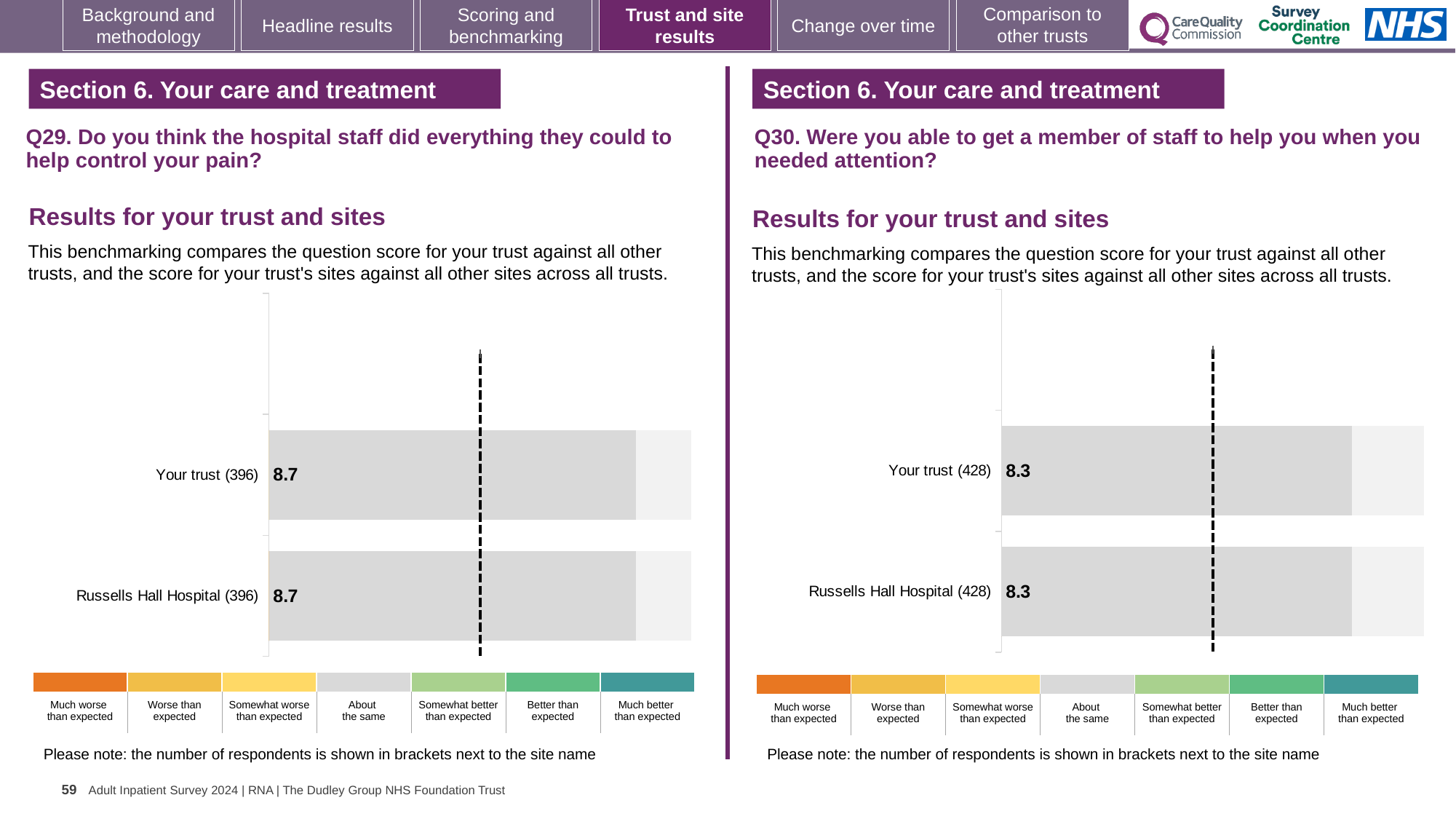
In the Q30 chart on the right, what is the difference between the score for Your trust and the score for Russells Hall Hospital? 0 In the Q29 chart on the left, what is the difference between the score for Your trust and the score for Russells Hall Hospital? 0 In the Q29 chart on the left, what is the score for Your trust? 8.7 In the Q30 chart on the right, what is the score for Your trust? 8.3 How many bars are plotted in the Q30 chart on the right? 2 What kind of chart is the Q29 chart on the left? Bar chart Is the score for Your trust in the Q29 chart on the left larger or smaller than the score for Your trust in the Q30 chart on the right? Larger How many bars are plotted in the Q29 chart on the left? 2 In the Q29 chart on the left, how many respondents are shown in brackets next to Your trust? 396 In the Q29 chart on the left, what is the score for Russells Hall Hospital? 8.7 In the Q30 chart on the right, how many respondents are shown in brackets next to Russells Hall Hospital? 428 In the Q30 chart on the right, what is the score for Russells Hall Hospital? 8.3